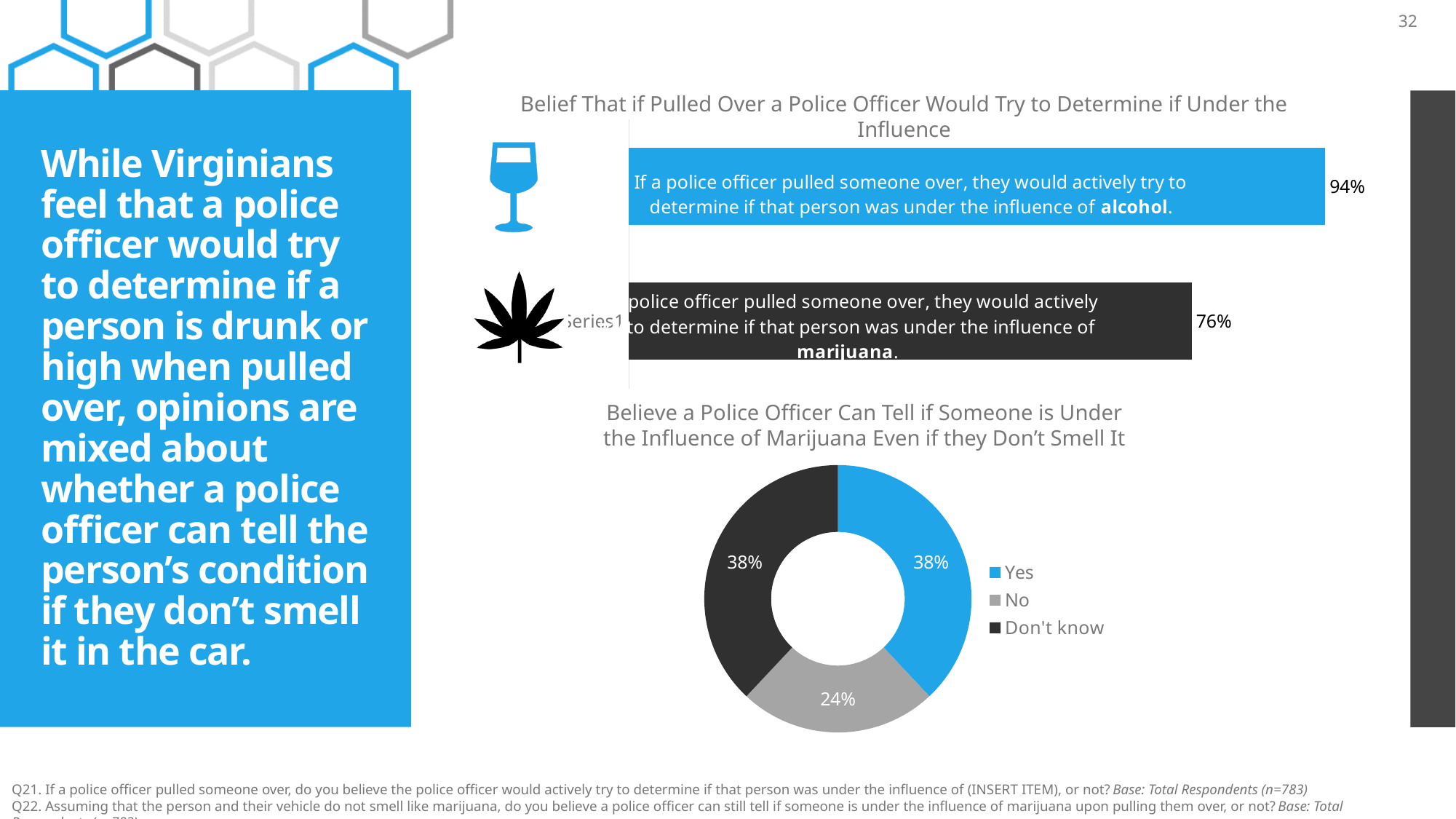
In the chart titled "Belief That if Pulled Over a Police Officer Would Try to Determine if Under the Influence", what percentage believe an officer would try to determine if the person was under the influence of marijuana? 76% In the chart titled "Believe a Police Officer Can Tell if Someone is Under the Influence of Marijuana Even if they Don't Smell It", what share answered Yes? 38% In the chart titled "Belief That if Pulled Over a Police Officer Would Try to Determine if Under the Influence", which substance has the higher percentage, alcohol or marijuana? alcohol What kind of chart is the one titled "Belief That if Pulled Over a Police Officer Would Try to Determine if Under the Influence"? bar chart In the chart titled "Belief That if Pulled Over a Police Officer Would Try to Determine if Under the Influence", what percentage believe an officer would try to determine if the person was under the influence of alcohol? 94% How many categories does the legend list in the chart titled "Believe a Police Officer Can Tell if Someone is Under the Influence of Marijuana Even if they Don't Smell It"? 3 In the chart titled "Believe a Police Officer Can Tell if Someone is Under the Influence of Marijuana Even if they Don't Smell It", what share answered No? 24% How many bars are in the chart titled "Belief That if Pulled Over a Police Officer Would Try to Determine if Under the Influence"? 2 In the chart titled "Believe a Police Officer Can Tell if Someone is Under the Influence of Marijuana Even if they Don't Smell It", what share answered Don't know? 38% What kind of chart is the one titled "Believe a Police Officer Can Tell if Someone is Under the Influence of Marijuana Even if they Don't Smell It"? doughnut chart In the chart titled "Belief That if Pulled Over a Police Officer Would Try to Determine if Under the Influence", what is the difference in percentage points between the alcohol and marijuana bars? 18 In the chart titled "Believe a Police Officer Can Tell if Someone is Under the Influence of Marijuana Even if they Don't Smell It", which response has the smallest share? No